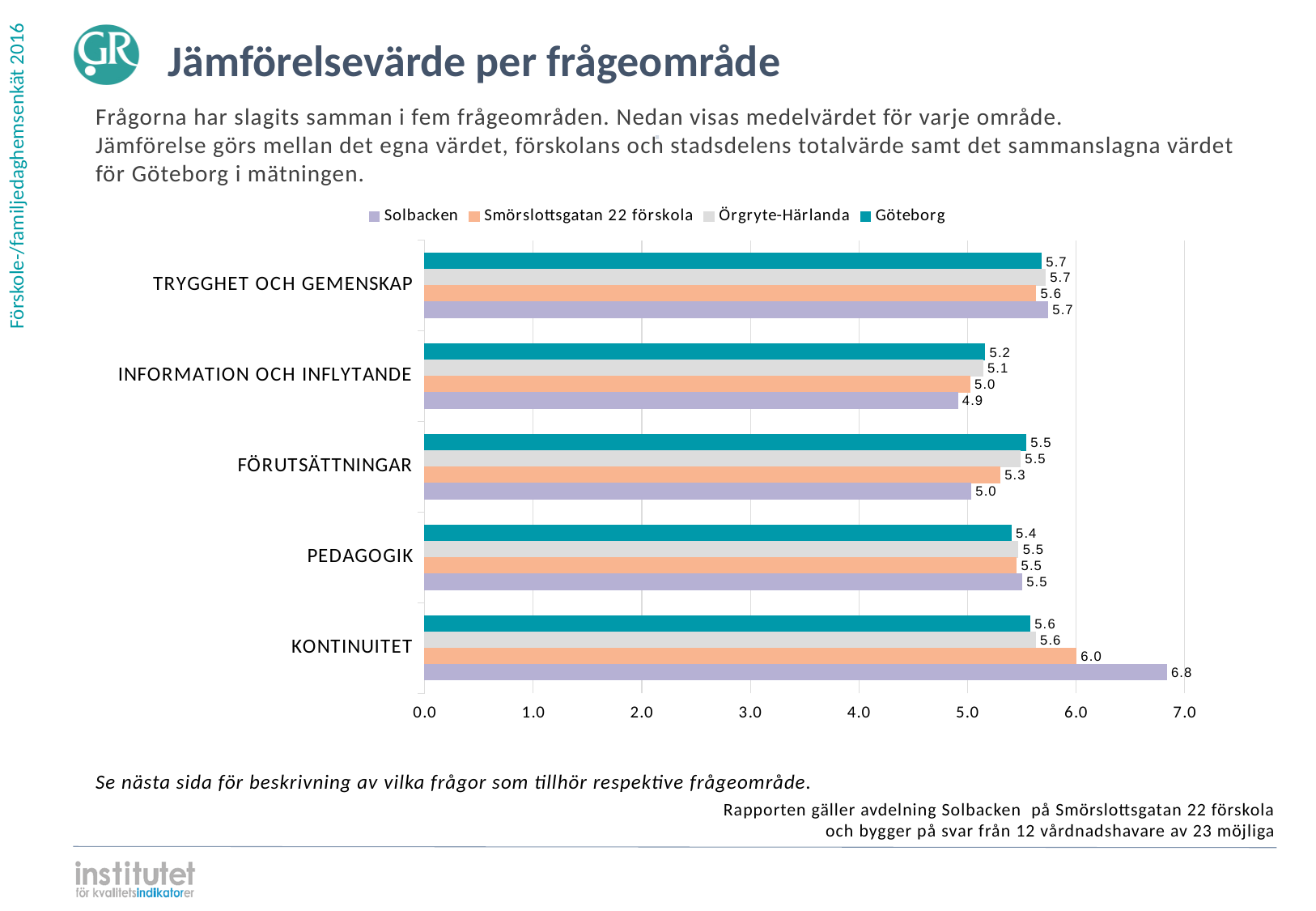
How many series does the legend list? 4 What is the value for Smörslottsgatan 22 förskola in the FÖRUTSÄTTNINGAR category? 5.3 What is the value for Solbacken in the KONTINUITET category? 6.8 What is the difference between the Solbacken value and the Göteborg value in the KONTINUITET category? 1.2 What is the value for Örgryte-Härlanda in the PEDAGOGIK category? 5.5 In which category does Solbacken have its lowest value? INFORMATION OCH INFLYTANDE Which series is shown in purple in the legend? Solbacken What kind of chart is shown on the slide? Bar chart In the FÖRUTSÄTTNINGAR category, which is larger: the value for Göteborg or the value for Solbacken? Göteborg In which category does Solbacken have its highest value? KONTINUITET What is the value for Göteborg in the INFORMATION OCH INFLYTANDE category? 5.2 How many question areas (categories) are shown on the chart? 5